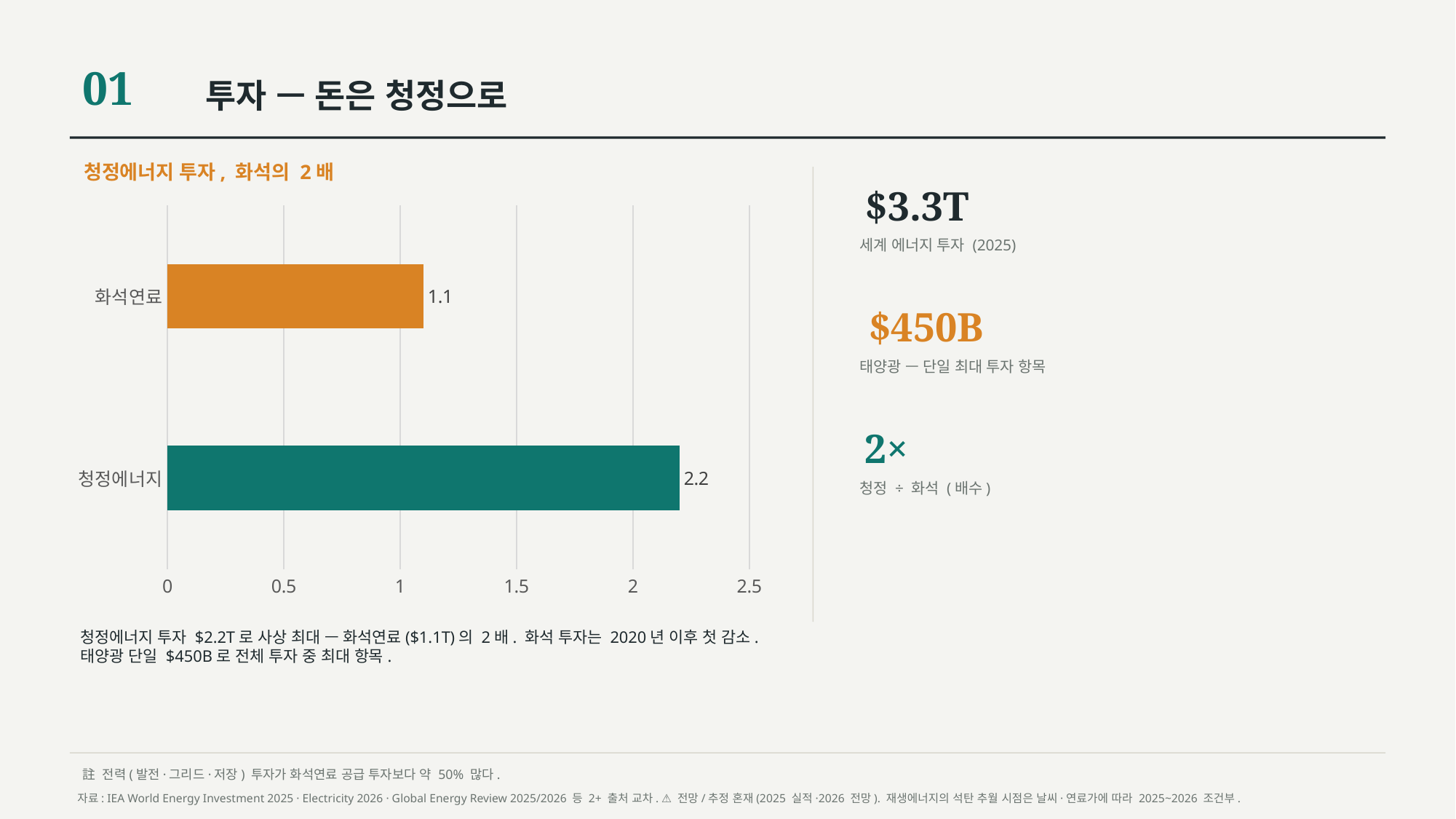
Is the value for 청정에너지 greater or less than 2? greater Which is larger, the value for 화석연료 or the value for 청정에너지? 청정에너지 Which category has the lowest value? 화석연료 Which category has the highest value? 청정에너지 What is the value for 화석연료? 1.1 What is the maximum value shown on the x axis? 2.5 What is the difference between the values for 청정에너지 and 화석연료? 1.1 Is the value for 화석연료 greater or less than 1.5? less What is the title of the chart? 청정에너지 투자, 화석의 2배 What is the value for 청정에너지? 2.2 What kind of chart is shown on the slide? bar chart How many categories are shown in the chart? 2